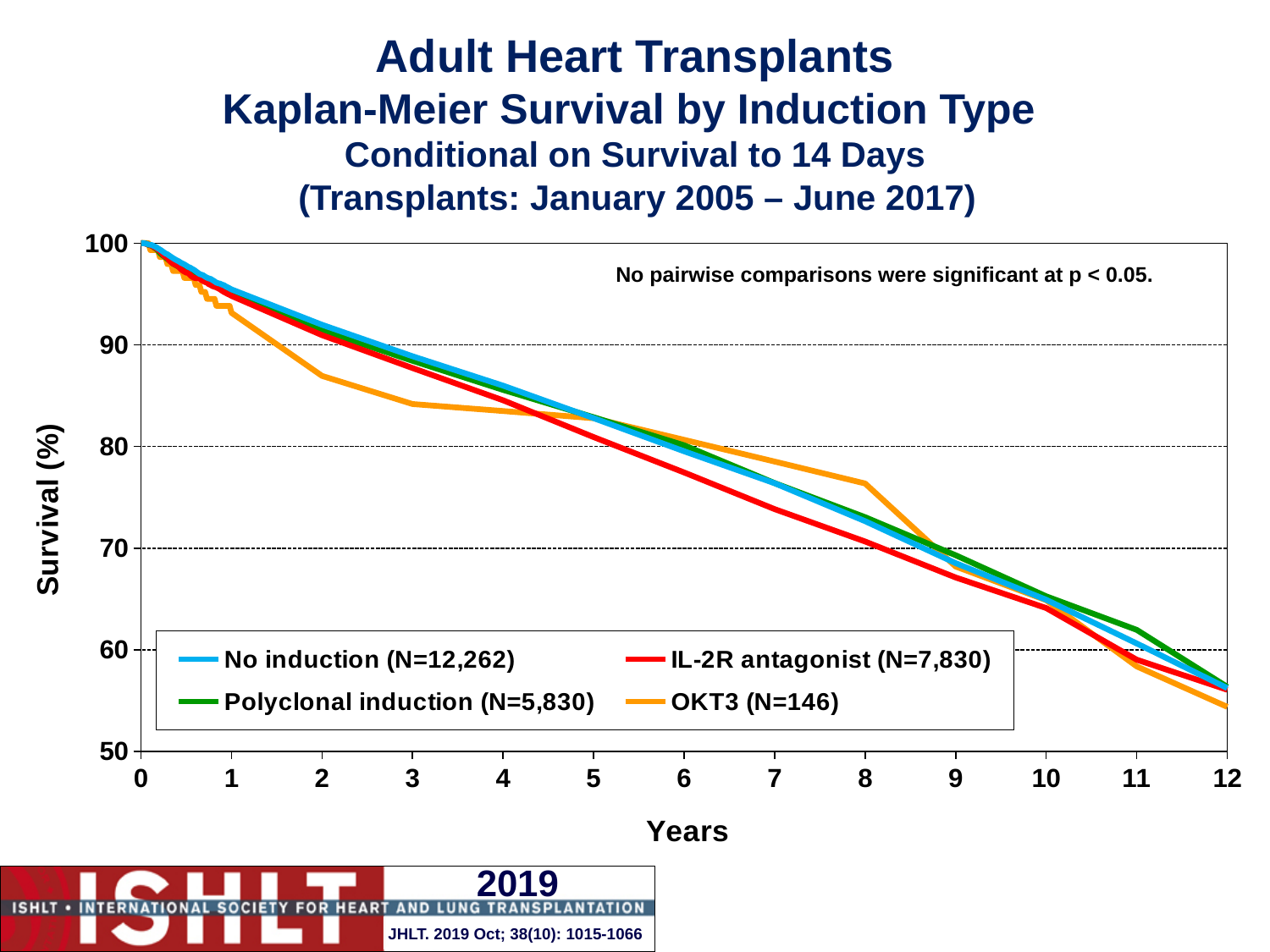
What is the survival (%) for all induction types at year 0? 100 Is the survival for No induction at year 5 greater or less than 80? greater Do the survival curves rise or fall as years increase? fall According to the note on the chart, were any pairwise comparisons significant at p < 0.05? No Which induction type has the lowest survival at year 12? OKT3 At year 8, which has higher survival: OKT3 or IL-2R antagonist? OKT3 At year 2, which has higher survival: OKT3 or No induction? No induction Is the survival for OKT3 at year 8 greater or less than 80? less What kind of chart is shown on the slide? line chart Is the survival for IL-2R antagonist at year 12 greater or less than 60? less How many series does the legend list? 4